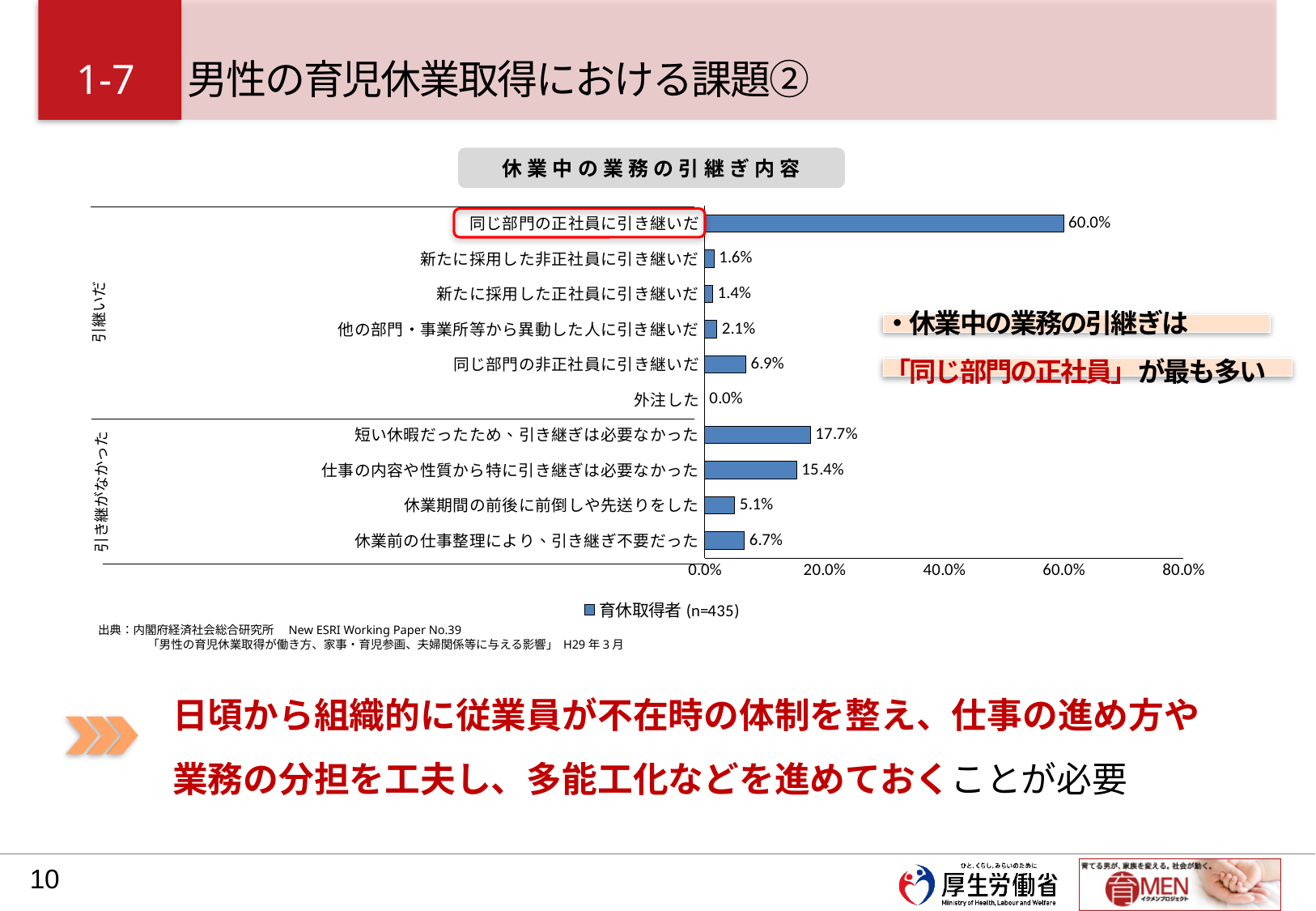
Which category has the lowest value? 外注した What is the difference between 短い休暇だったため、引き継ぎは必要なかった and 仕事の内容や性質から特に引き継ぎは必要なかった? 2.3% What is the value for 同じ部門の非正社員に引き継いだ? 6.9% How many categories are shown in the chart? 10 What is the value for 外注した? 0.0% Is the value for 同じ部門の正社員に引き継いだ greater or less than 40.0%? greater What is the value for 短い休暇だったため、引き継ぎは必要なかった? 17.7% Which category has the highest value? 同じ部門の正社員に引き継いだ What kind of chart is shown on the slide? bar chart What is the legend entry of the chart? 育休取得者 (n=435) What is the value for 同じ部門の正社員に引き継いだ? 60.0% Which is larger: 休業期間の前後に前倒しや先送りをした or 休業前の仕事整理により、引き継ぎ不要だった? 休業前の仕事整理により、引き継ぎ不要だった